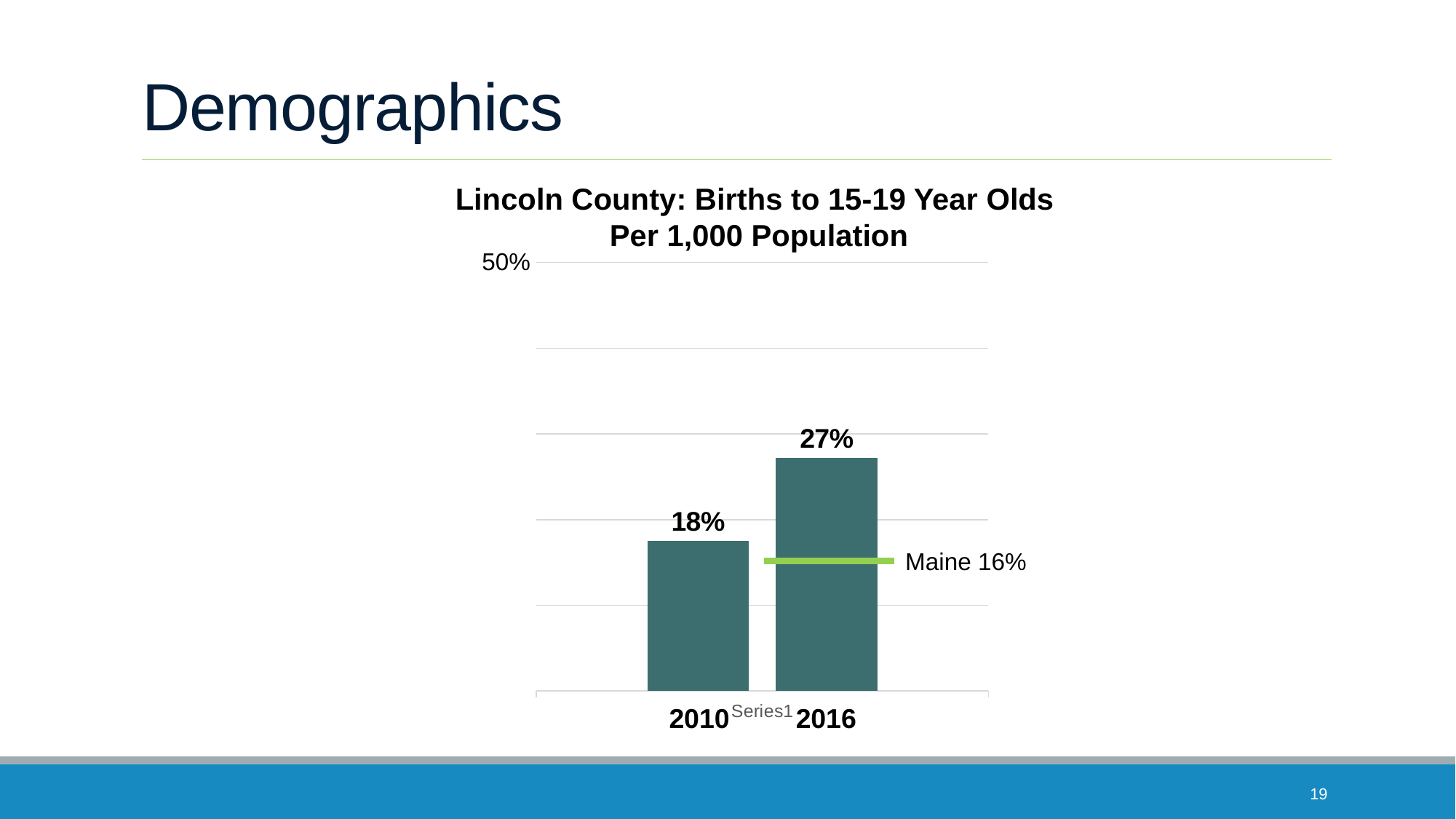
What value is shown for Maine by the green reference line? 16% What is the value for 2010? 18% What kind of chart is shown? bar chart Is the value for 2016 greater or less than 50%? less Which year has the higher value, 2010 or 2016? 2016 Which year has the lower value? 2010 What is the value for 2016? 27% What is the title of the chart? Lincoln County: Births to 15-19 Year Olds Per 1,000 Population How many bars are plotted in the chart? 2 Do the values rise or fall from 2010 to 2016? rise Is the 2016 value greater or less than the Maine value? greater What is the difference between the 2016 and 2010 values? 9%